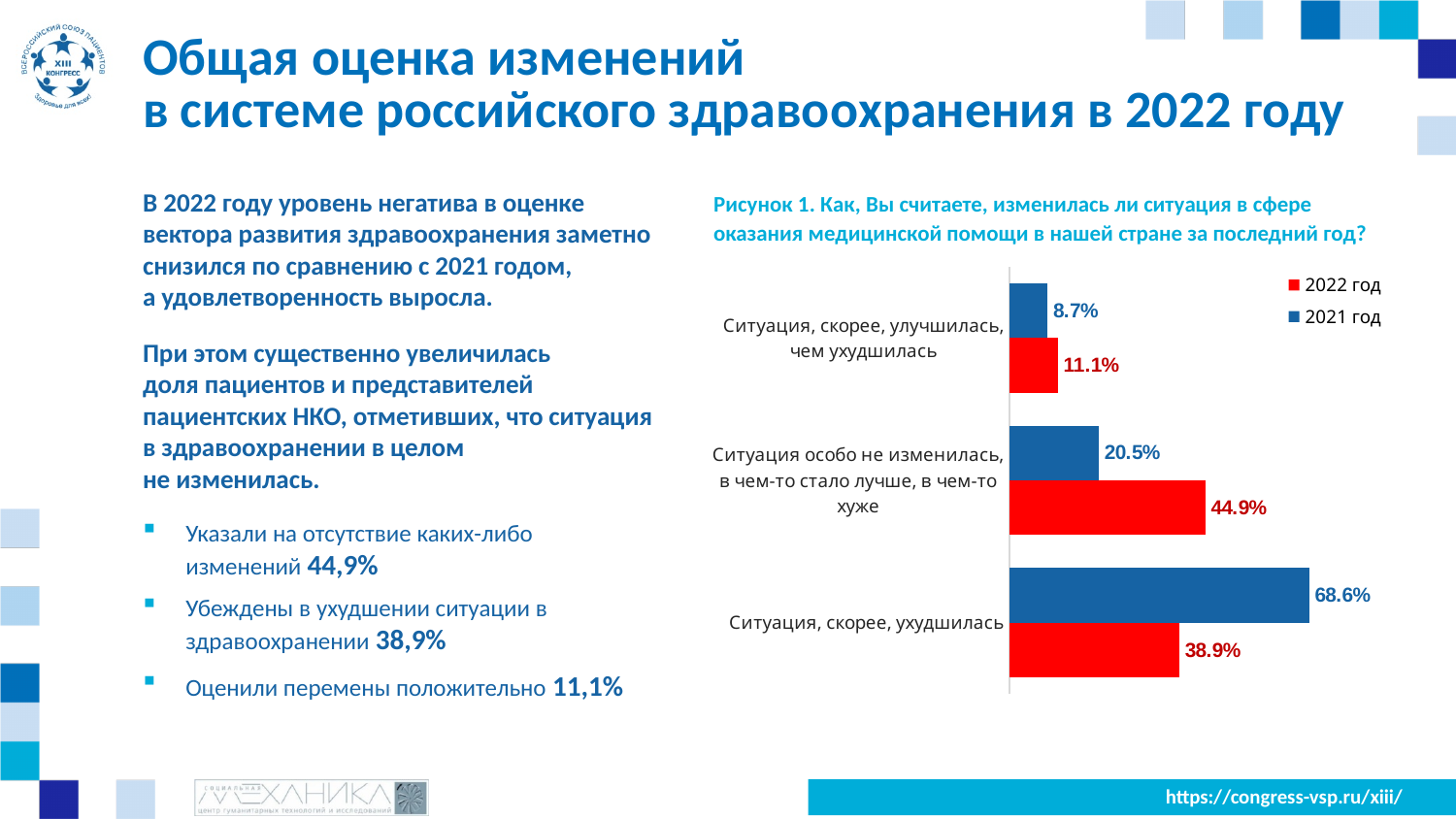
What is the value for 2022 год for the category "Ситуация особо не изменилась, в чем-то стало лучше, в чем-то хуже"? 44.9% What is the value for 2021 год for the category "Ситуация, скорее, улучшилась, чем ухудшилась"? 8.7% What type of chart is shown on the slide? Bar chart What is the value for 2021 год for the category "Ситуация, скорее, ухудшилась"? 68.6% For the category "Ситуация особо не изменилась, в чем-то стало лучше, в чем-то хуже", which series has the larger value, 2022 год or 2021 год? 2022 год Which category has the lowest value for 2022 год? Ситуация, скорее, улучшилась, чем ухудшилась How many categories are shown on the chart? 3 Which category has the highest value for 2021 год? Ситуация, скорее, ухудшилась What is the value for 2022 год for the category "Ситуация, скорее, ухудшилась"? 38.9% Which colour represents the 2022 год series in the chart? Red How many series does the chart legend list? 2 What is the difference between the 2021 год and 2022 год values for "Ситуация, скорее, ухудшилась"? 29.7%